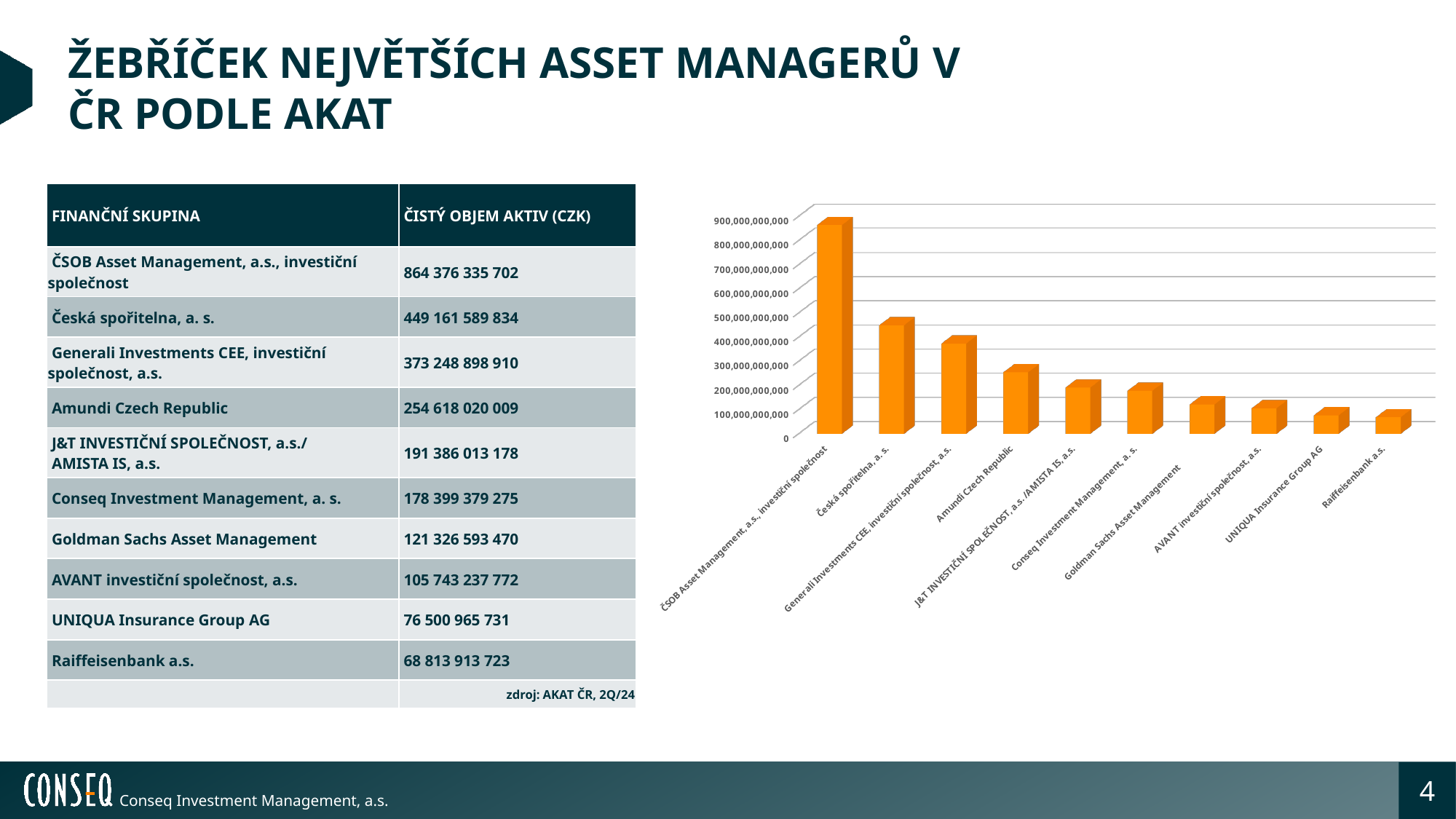
Do the bar values rise or fall from left to right along the x axis? fall What is the difference in net asset volume (CZK) between ČSOB Asset Management, a.s., investiční společnost and Česká spořitelna, a. s., using the table values? 415 214 745 868 According to the table, what is the net asset volume (CZK) for Conseq Investment Management, a. s.? 178 399 379 275 Which asset manager has the lowest net asset volume in the chart? Raiffeisenbank a.s. According to the table, what is the net asset volume (CZK) for Raiffeisenbank a.s.? 68 813 913 723 In the chart, is the value for UNIQUA Insurance Group AG greater or less than 100,000,000,000? less Which asset manager has the highest net asset volume in the chart? ČSOB Asset Management, a.s., investiční společnost Which is larger in the chart: Generali Investments CEE, investiční společnost, a.s. or Goldman Sachs Asset Management? Generali Investments CEE, investiční společnost, a.s. According to the table, what is the net asset volume (CZK) for Česká spořitelna, a. s.? 449 161 589 834 How many asset managers (bars) are shown in the chart? 10 What kind of chart is shown on the right of the slide? bar chart In the chart, is the value for Amundi Czech Republic greater or less than 200,000,000,000? greater